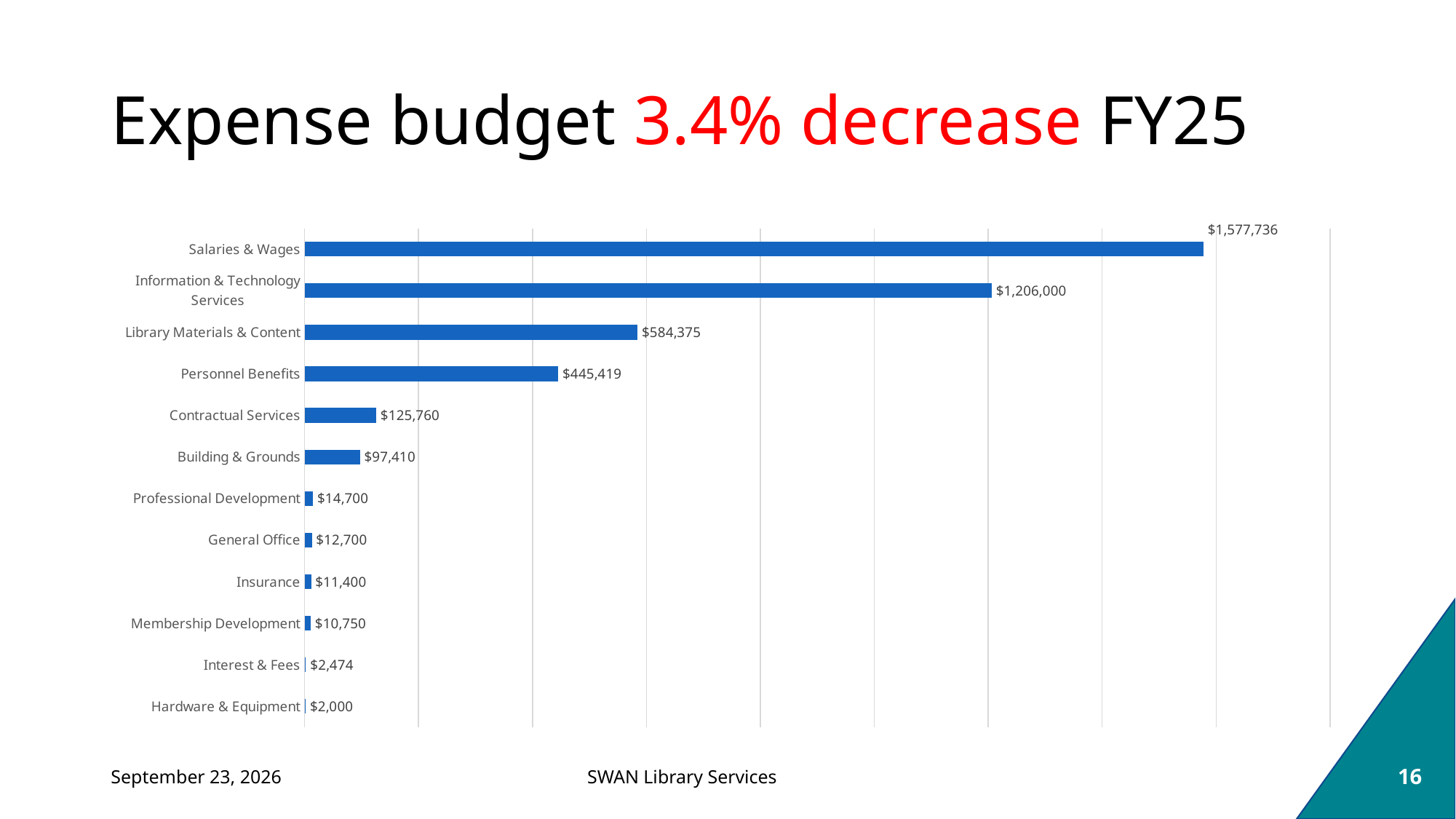
What is the difference between Library Materials & Content and Personnel Benefits? $138,956 What is the value for Salaries & Wages? $1,577,736 What is the difference between Salaries & Wages and Information & Technology Services? $371,736 How many categories are shown in the chart? 12 Which is larger, Contractual Services or Building & Grounds? Contractual Services What is the value for Membership Development? $10,750 What is the title of the slide containing the chart? Expense budget 3.4% decrease FY25 Which category has the lowest value? Hardware & Equipment What is the value for Building & Grounds? $97,410 Which category has the highest value? Salaries & Wages What is the value for Library Materials & Content? $584,375 What kind of chart is shown on the slide? Bar chart